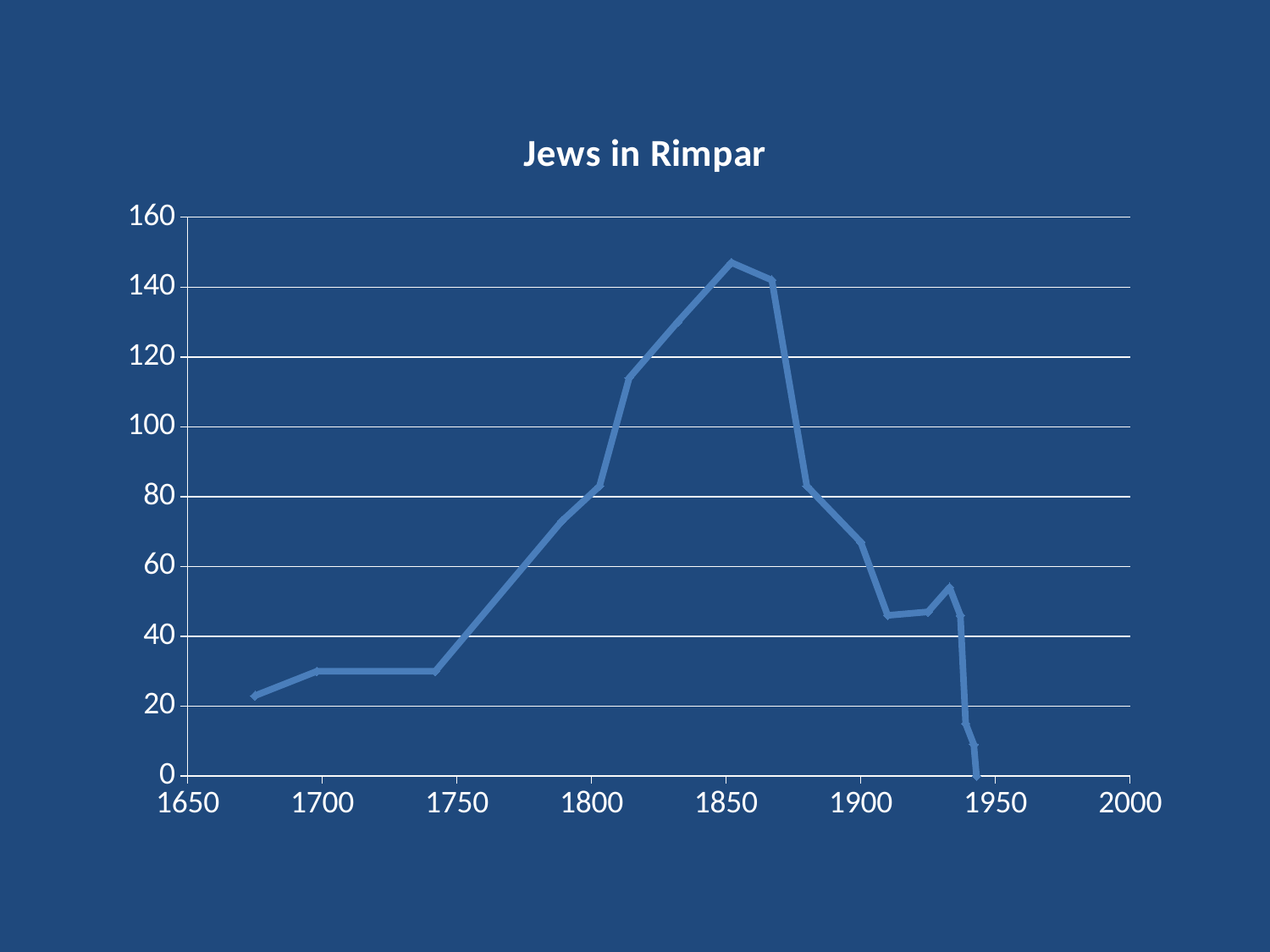
Is the value around 1750 greater or less than 60? less Does the line rise or fall between 1750 and 1850? rise What is the lowest value the line reaches? 0 Around which year does the line reach its highest value? around 1850 Is the value around 1700 greater or less than 40? less Which is larger, the value around 1800 or the value around 1900? around 1800 Is the value around 1900 greater or less than 60? greater What kind of chart is shown on the slide? line chart What is the title of the chart? Jews in Rimpar Does the line rise or fall between 1850 and 1950? fall